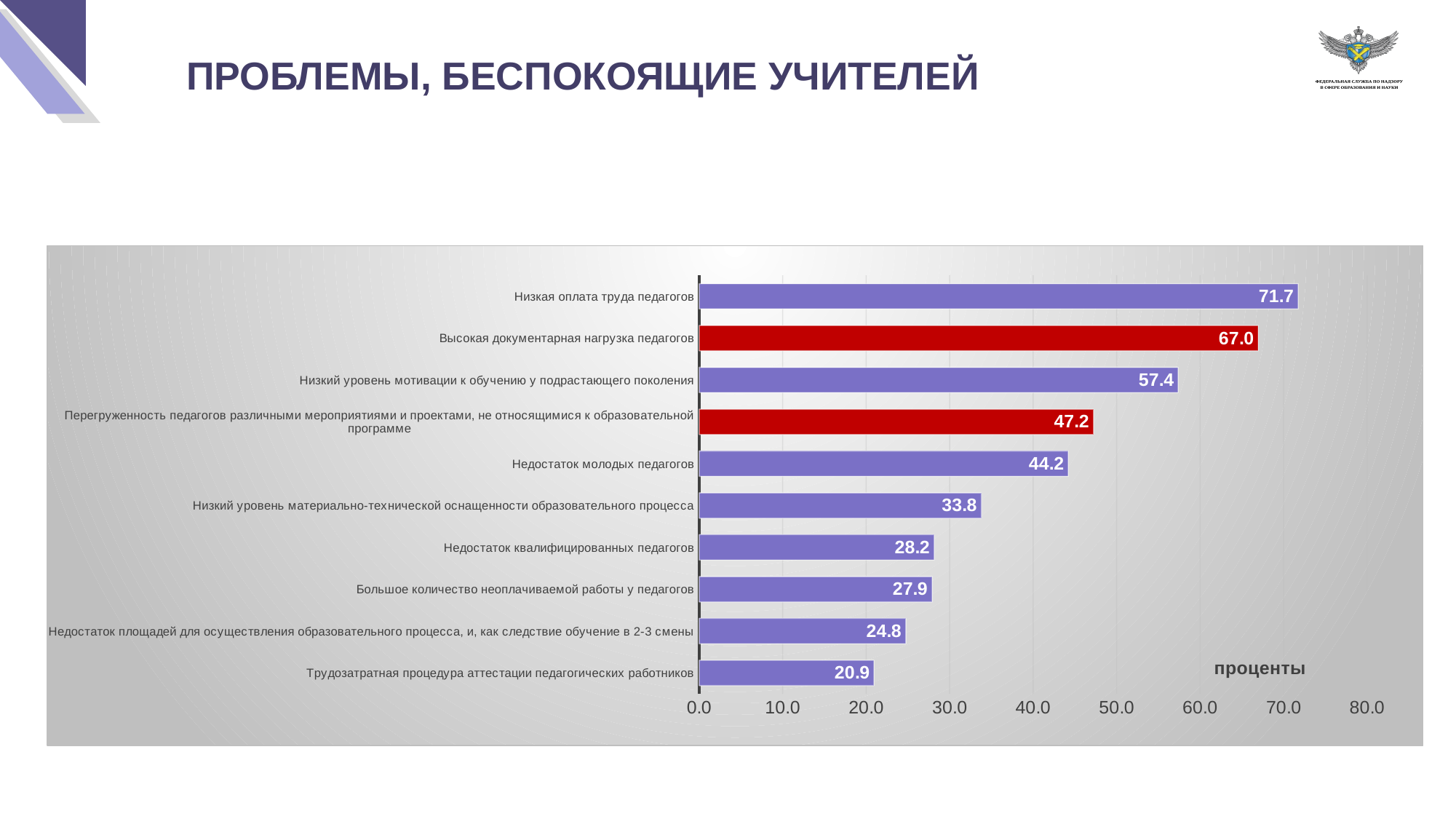
Which category has the highest value? Низкая оплата труда педагогов What is the value for "Низкая оплата труда педагогов"? 71.7 Which category has the lowest value? Трудозатратная процедура аттестации педагогических работников How many categories are shown in the chart? 10 Is the value for "Низкий уровень материально-технической оснащенности образовательного процесса" greater or less than 30.0? greater Which is larger: the value for "Недостаток квалифицированных педагогов" or for "Большое количество неоплачиваемой работы у педагогов"? Недостаток квалифицированных педагогов What kind of chart is shown on the slide? bar chart What is the value for "Недостаток молодых педагогов"? 44.2 How many bars are coloured red? 2 What is the value for "Трудозатратная процедура аттестации педагогических работников"? 20.9 What is the difference between the values for "Высокая документарная нагрузка педагогов" and "Низкий уровень мотивации к обучению у подрастающего поколения"? 9.6 What is the title of the slide? ПРОБЛЕМЫ, БЕСПОКОЯЩИЕ УЧИТЕЛЕЙ